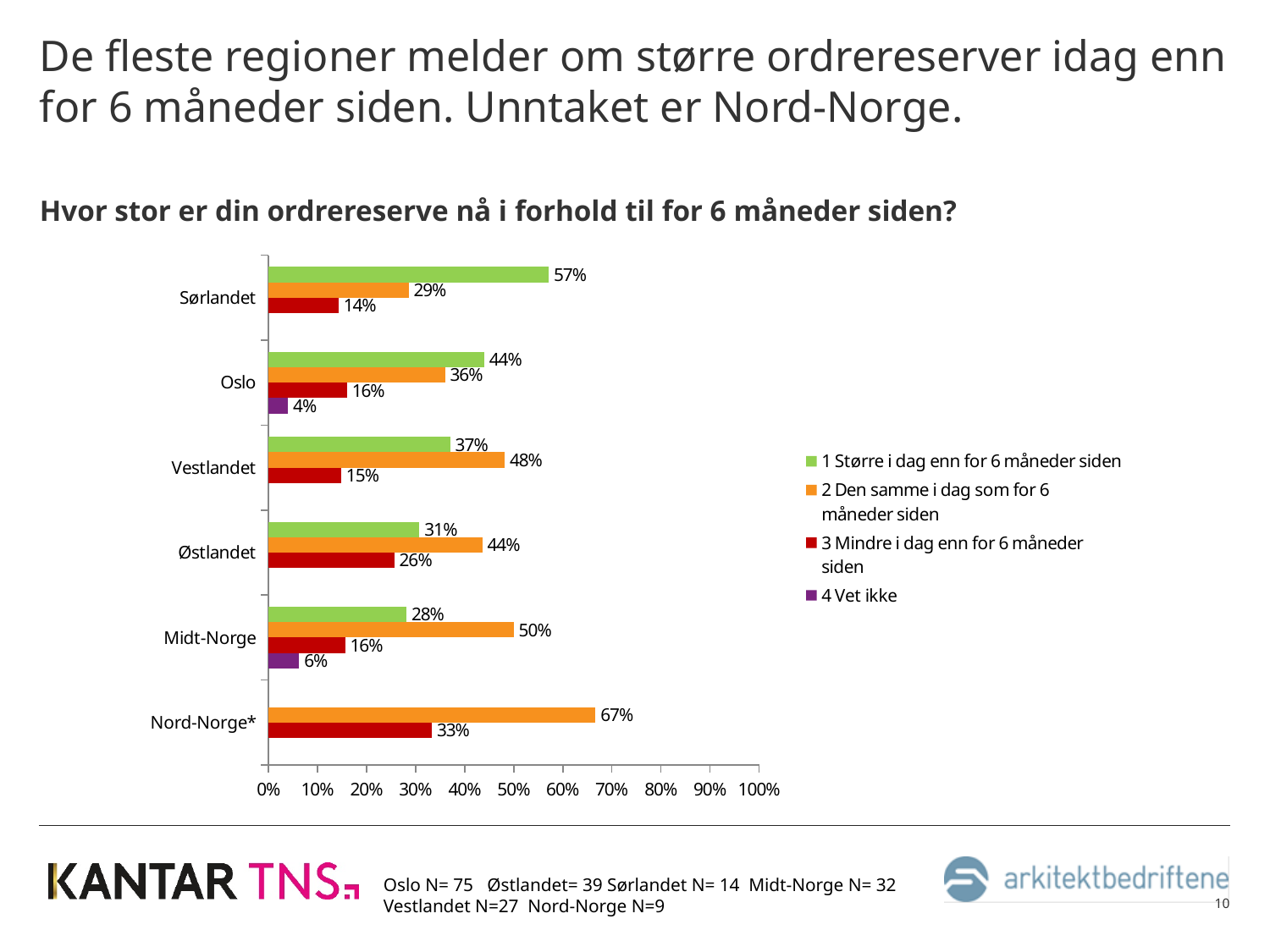
What percentage of respondents in Sørlandet report a larger order reserve today than 6 months ago ("1 Større i dag enn for 6 måneder siden")? 57% How many series does the legend list? 4 Which colour represents "4 Vet ikke" in the chart? Purple For Vestlandet, which is larger: "1 Større i dag enn for 6 måneder siden" or "2 Den samme i dag som for 6 måneder siden"? 2 Den samme i dag som for 6 måneder siden What kind of chart is shown on the slide? Bar chart What is the difference between the "1 Større i dag enn for 6 måneder siden" values for Sørlandet and Oslo? 13 percentage points How many regions are shown on the chart? 6 Which region has the lowest value for "2 Den samme i dag som for 6 måneder siden"? Sørlandet What is the value for "2 Den samme i dag som for 6 måneder siden" for Nord-Norge*? 67% Which region has the highest value for "1 Større i dag enn for 6 måneder siden"? Sørlandet What is the value for "4 Vet ikke" for Midt-Norge? 6% What is the value for "3 Mindre i dag enn for 6 måneder siden" for Østlandet? 26%